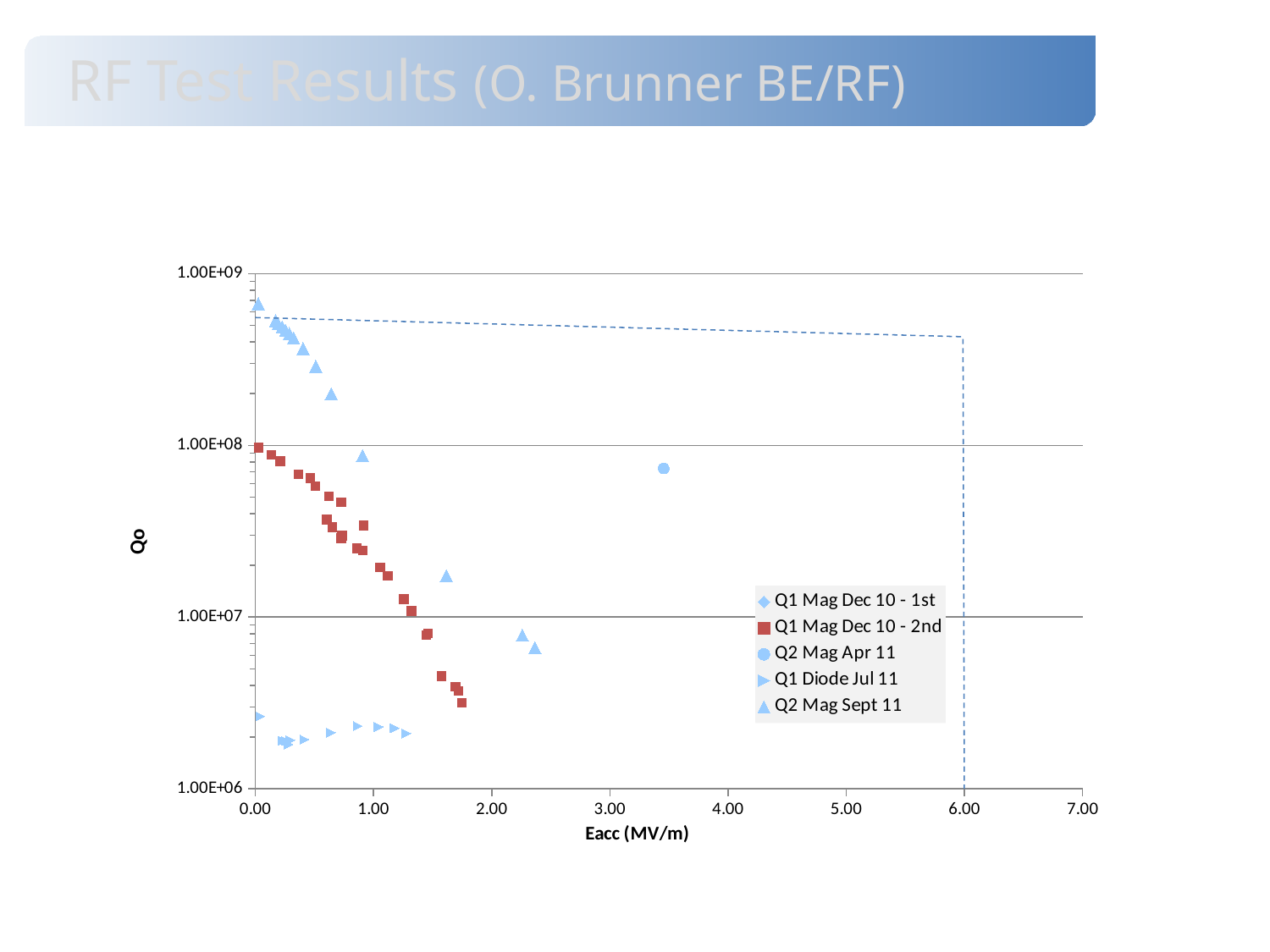
Which series reaches the highest Qo value on the chart? Q2 Mag Sept 11 How many series does the legend list? 5 What is the label of the y axis? Qo Does Qo for the Q1 Mag Dec 10 - 2nd series rise or fall as Eacc increases? fall What kind of chart is shown on the slide? scatter chart Is the Qo value of the single Q2 Mag Apr 11 point greater or less than 1.00E+07? greater Is the highest Qo value of the Q2 Mag Sept 11 series greater or less than 1.00E+08? greater Are the Qo values of the Q1 Diode Jul 11 series greater or less than 1.00E+07? less At Eacc near 0.00, which series has the larger Qo: Q2 Mag Sept 11 or Q1 Mag Dec 10 - 2nd? Q2 Mag Sept 11 What is the label of the x axis? Eacc (MV/m) Which series has the lowest Qo values on the chart? Q1 Diode Jul 11